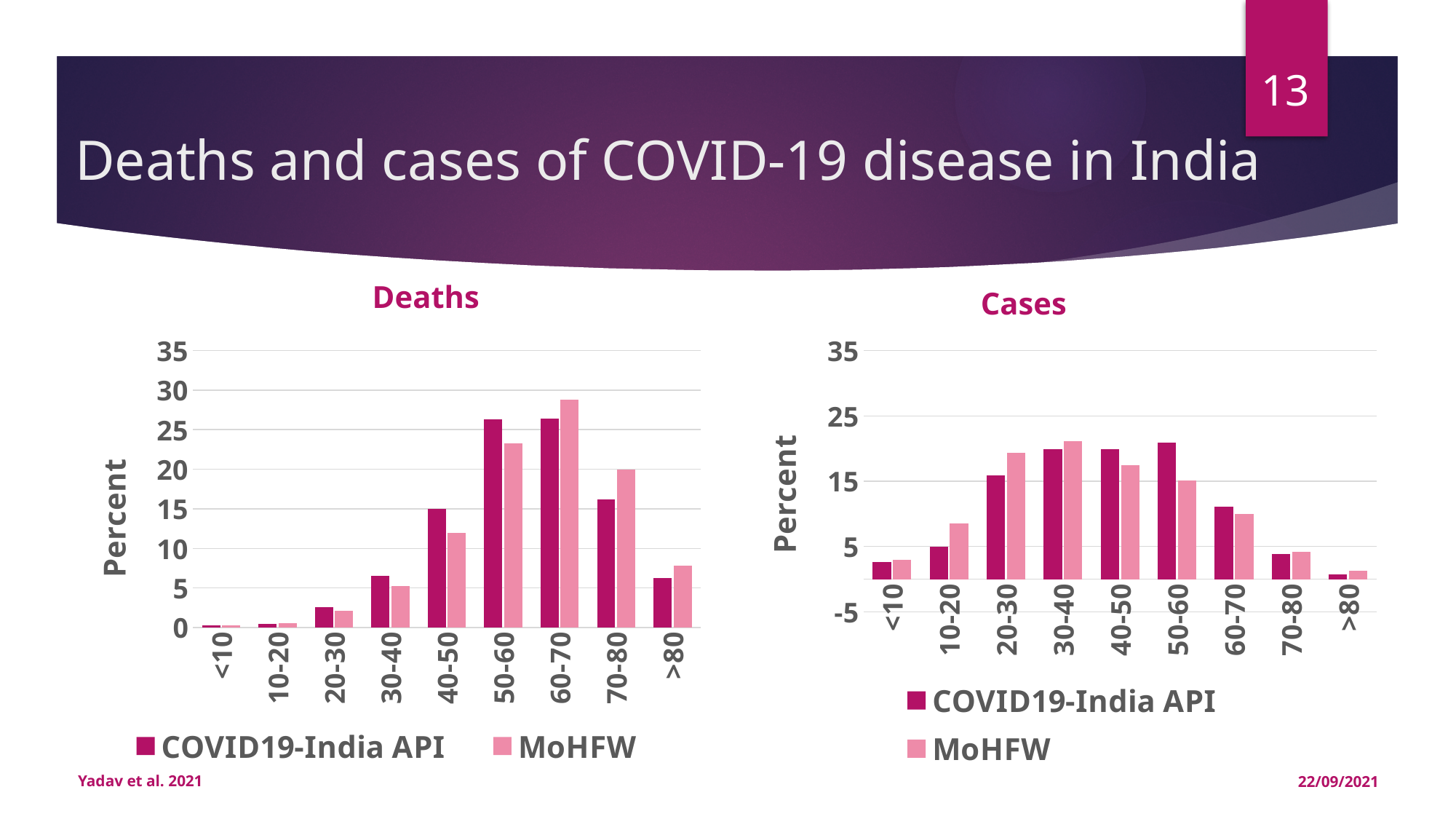
How many series does the legend of the Deaths chart list? 2 In the Deaths chart, is the COVID19-India API value for 50-60 greater or less than 25? greater In the Deaths chart, which is larger for the 70-80 age group: the COVID19-India API value or the MoHFW value? MoHFW What is the y-axis label of the Cases chart? Percent In the Cases chart, which is larger for the 10-20 age group: the COVID19-India API value or the MoHFW value? MoHFW In the Cases chart, which age group has the lowest COVID19-India API value? >80 In the Deaths chart, which age group has the highest MoHFW value? 60-70 How many age categories are shown on the x axis of the Cases chart? 9 In the Deaths chart, is the MoHFW value for 40-50 greater or less than 15? less In the Cases chart, which age group has the highest MoHFW value? 30-40 What kind of chart is the Deaths chart? bar chart In the Cases chart, is the COVID19-India API value for 50-60 greater or less than 15? greater